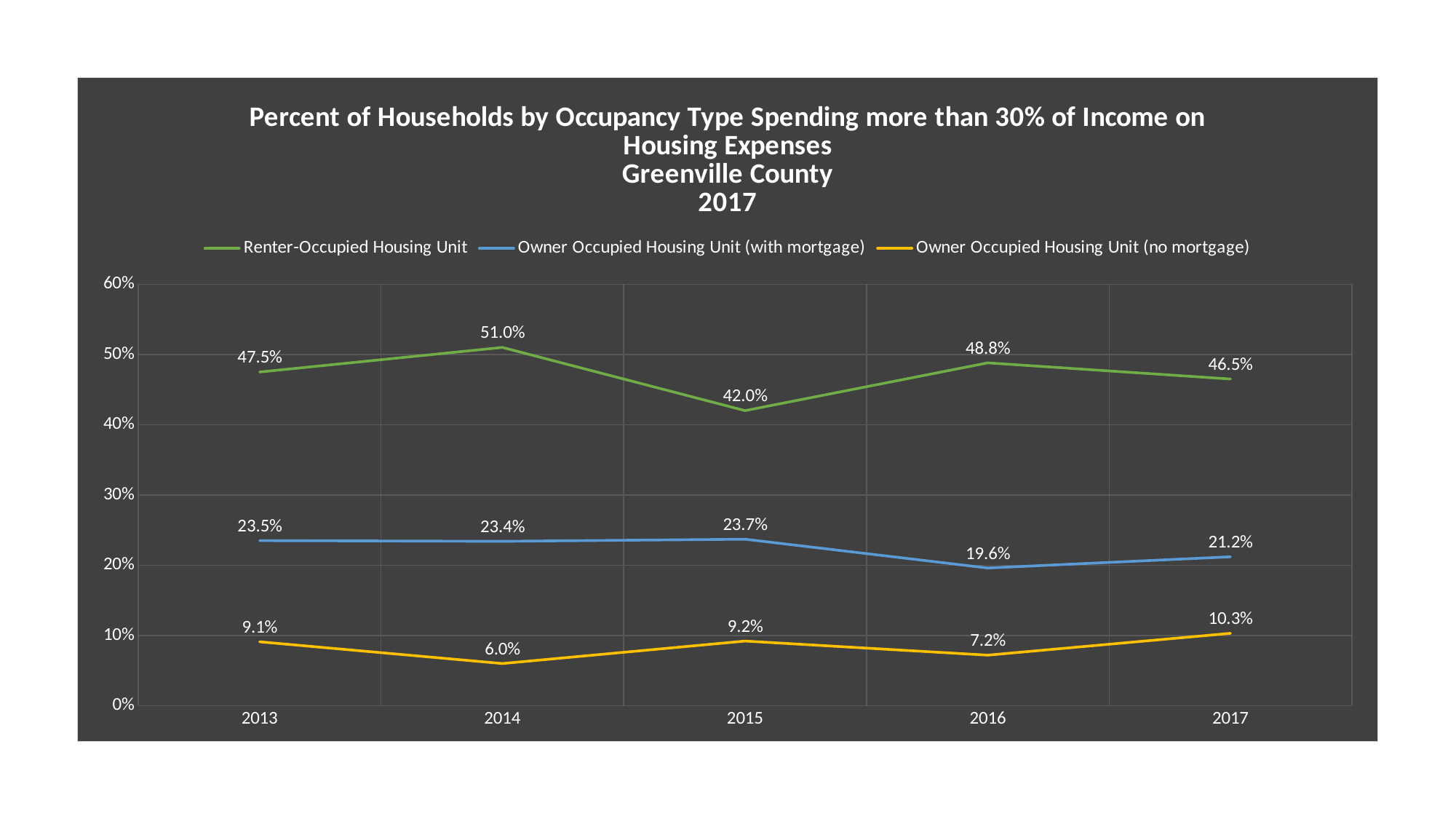
How many years are shown on the x axis? 5 Does the Owner Occupied Housing Unit (no mortgage) value rise or fall from 2016 to 2017? rise How many series does the legend list? 3 In which year is the Owner Occupied Housing Unit (no mortgage) value lowest? 2014 In which year is the Renter-Occupied Housing Unit value highest? 2014 Is the Renter-Occupied Housing Unit value in 2015 greater or less than 40%? greater Which is larger: the Owner Occupied Housing Unit (with mortgage) value in 2013 or in 2017? 2013 What is the value for Owner Occupied Housing Unit (with mortgage) in 2016? 19.6% What is the difference between the Renter-Occupied Housing Unit values in 2014 and 2015? 9.0% What is the value for Renter-Occupied Housing Unit in 2014? 51.0% What is the value for Owner Occupied Housing Unit (no mortgage) in 2017? 10.3% What kind of chart is shown on the slide? line chart